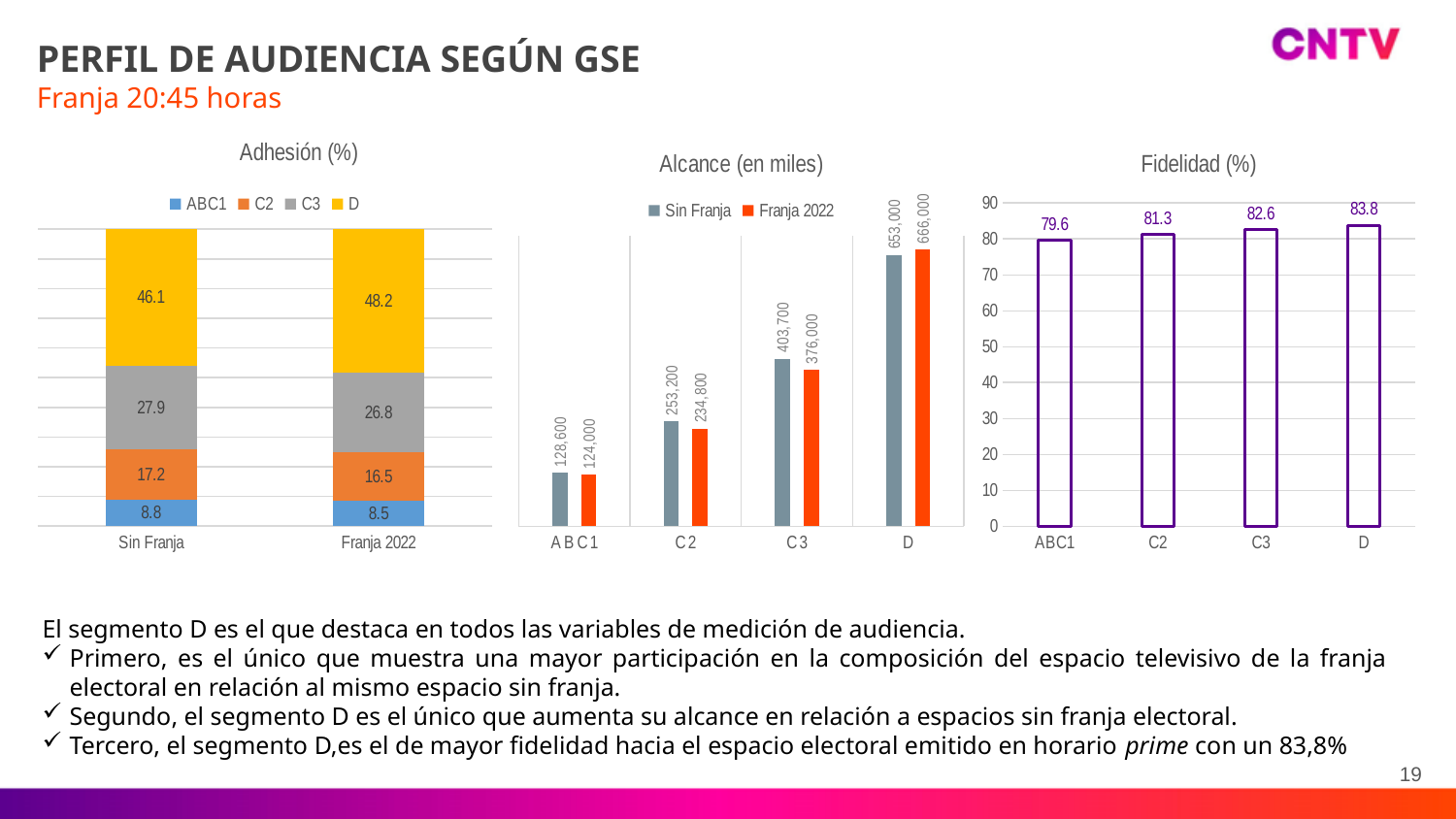
In the 'Fidelidad (%)' chart, do the values rise or fall from ABC1 to D? rise In the 'Adhesión (%)' chart, what is the value for segment D in the 'Franja 2022' bar? 48.2 In the 'Adhesión (%)' chart, what is the difference between the ABC1 values for 'Sin Franja' and 'Franja 2022'? 0.3 In the 'Alcance (en miles)' chart, what is the difference between the 'Sin Franja' and 'Franja 2022' values for ABC1? 4,600 In the 'Adhesión (%)' chart, what is the value for segment C3 in the 'Sin Franja' bar? 27.9 In the 'Alcance (en miles)' chart, what is the 'Sin Franja' value for segment C3? 403,700 In the 'Fidelidad (%)' chart, what is the value for segment C2? 81.3 In the 'Alcance (en miles)' chart, which is larger for segment C2: 'Sin Franja' or 'Franja 2022'? Sin Franja In the 'Alcance (en miles)' chart, what is the 'Franja 2022' value for segment D? 666,000 In the 'Fidelidad (%)' chart, which segment has the lowest value? ABC1 In the 'Adhesión (%)' chart, how many series does the legend list? 4 In the 'Alcance (en miles)' chart, which segment has the highest 'Sin Franja' value? D